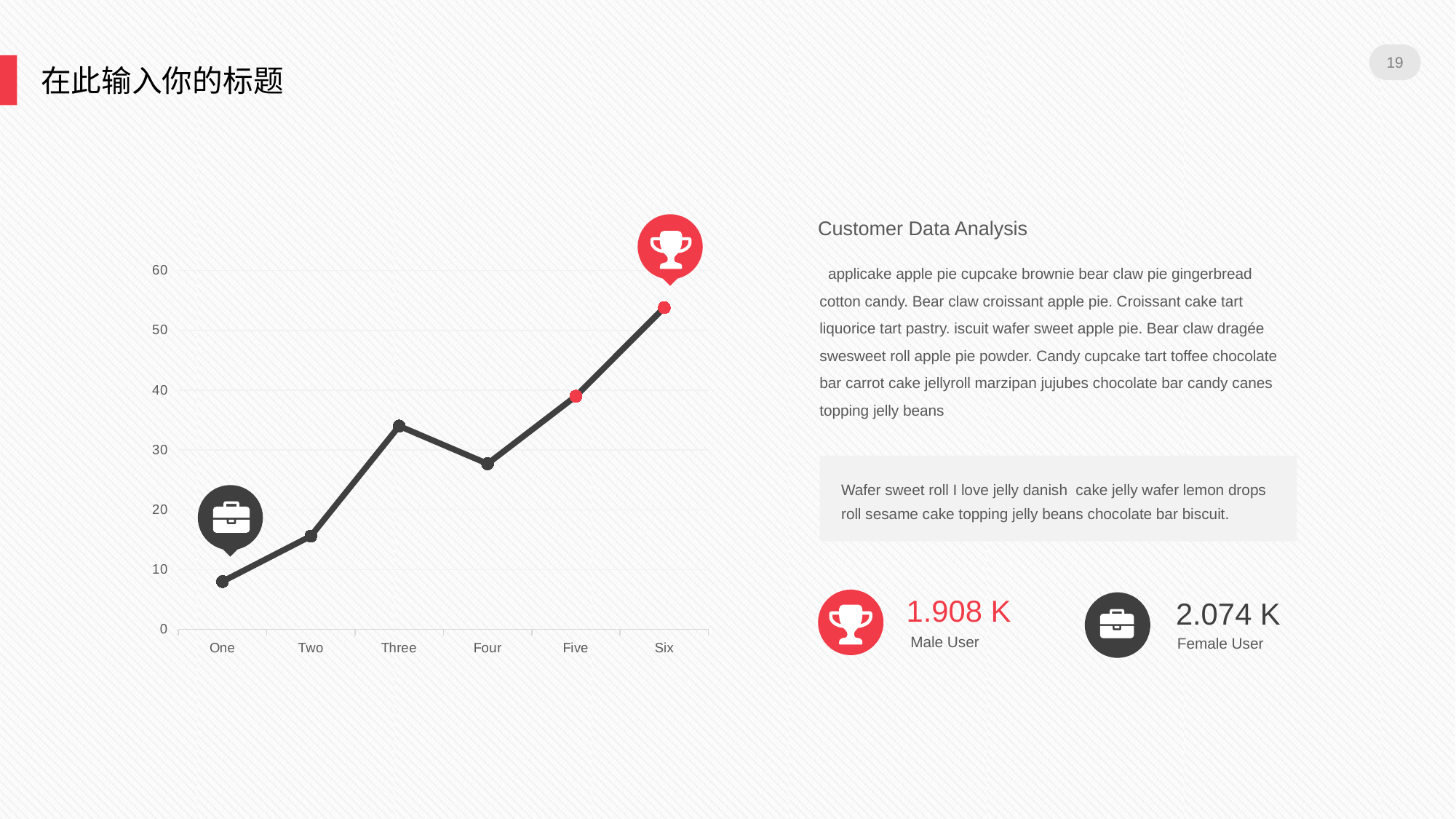
Is the value for One greater or less than 10? less Is the value for Three greater or less than 30? greater Which category has the lowest value in the line chart? One What kind of chart is shown on the slide? line chart Does the value rise or fall from Three to Four? fall What is the highest value shown on the y axis of the line chart? 60 How many categories are plotted along the x axis of the line chart? 6 Is the value for Two greater or less than 20? less Which category has the highest value in the line chart? Six Which is larger, the value for Three or the value for Four? Three Which is larger, the value for Two or the value for Four? Four